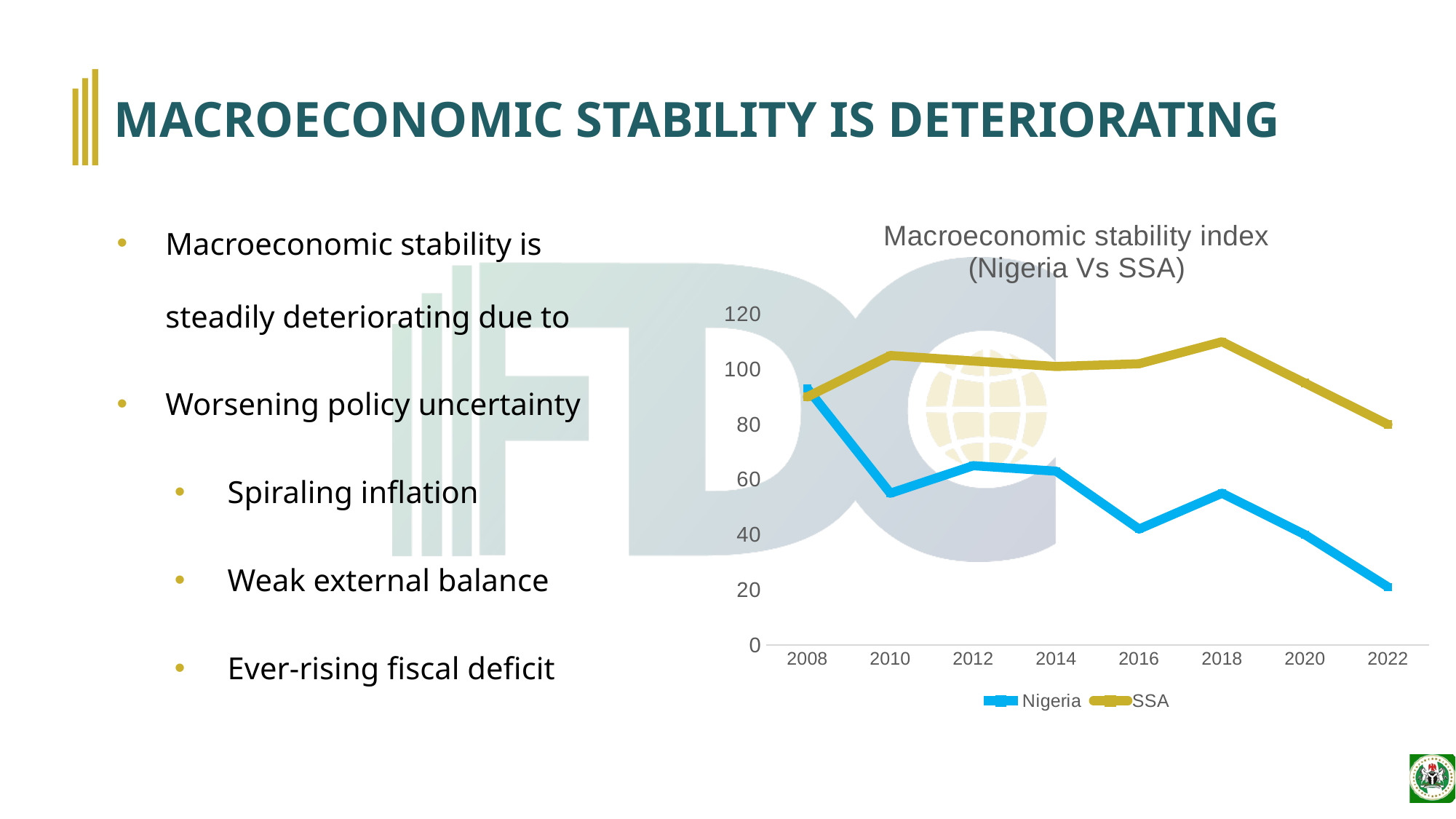
What kind of chart is shown on the slide? line chart In which year is the SSA value highest? 2018 Does the Nigeria line generally rise or fall from 2008 to 2022? fall Is the Nigeria value for 2016 greater or less than 60? less In which year is the Nigeria value lowest? 2022 Is the SSA value for 2010 greater or less than 100? greater Which series has the higher value in 2020, Nigeria or SSA? SSA Which colour is used for the Nigeria line in the chart? blue How many series does the legend of the chart list? 2 Is the Nigeria value for 2022 greater or less than 40? less How many years are shown on the x axis of the chart? 8 What is the title of the chart? Macroeconomic stability index (Nigeria Vs SSA)